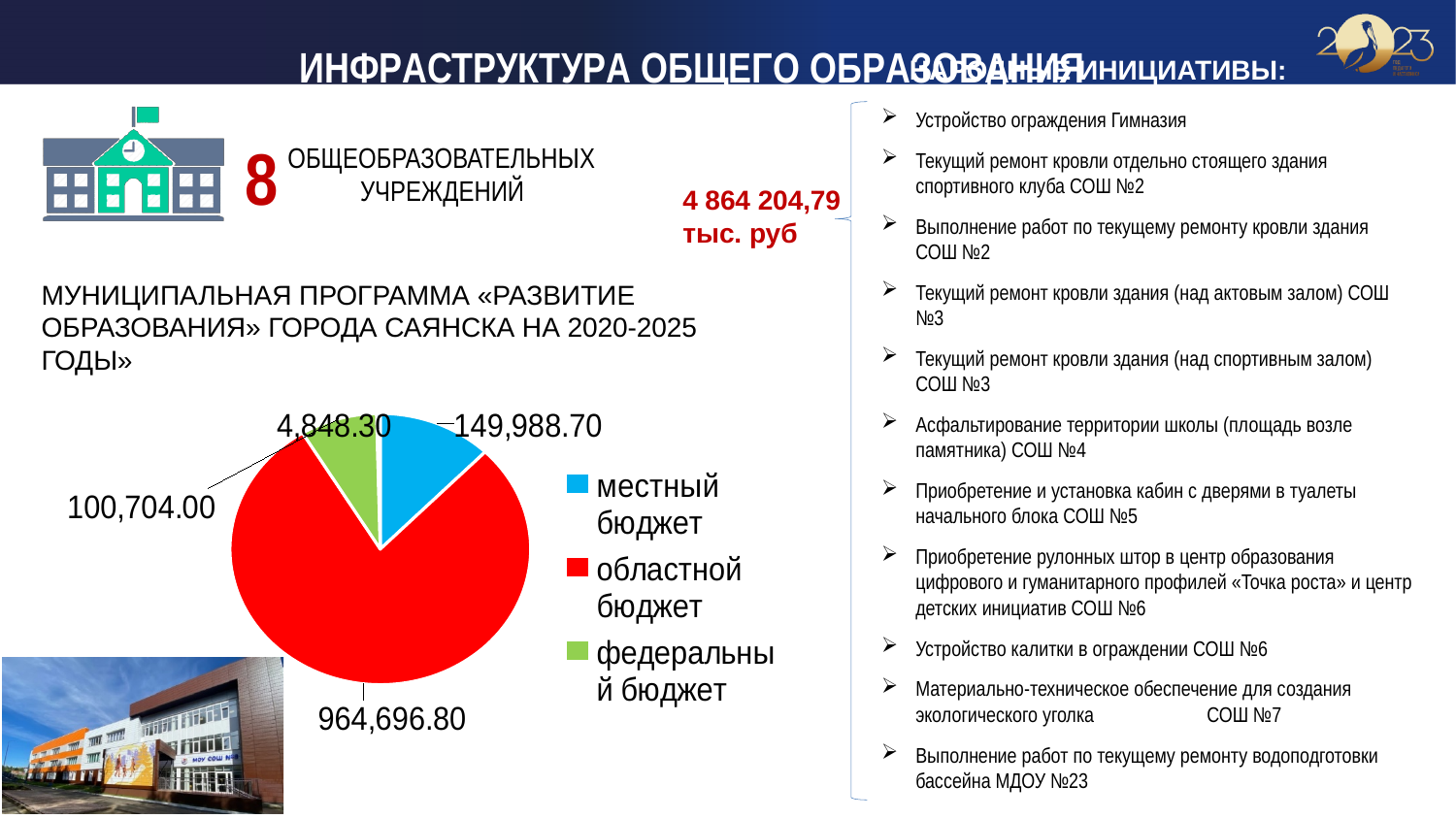
How many entries does the pie chart's legend list? 3 What is the value shown for местный бюджет in the pie chart? 149,988.70 Which budget category has the largest slice in the pie chart? областной бюджет What is the difference between the values for местный бюджет and федеральный бюджет? 49,284.70 What colour represents областной бюджет in the pie chart? red What is the value shown for областной бюджет in the pie chart? 964,696.80 Which is larger in the pie chart: местный бюджет or федеральный бюджет? местный бюджет What is the value shown for федеральный бюджет in the pie chart? 100,704.00 What type of chart is shown on the slide? pie chart What is the difference between the values for областной бюджет and местный бюджет? 814,708.10 What colour represents местный бюджет in the pie chart? blue